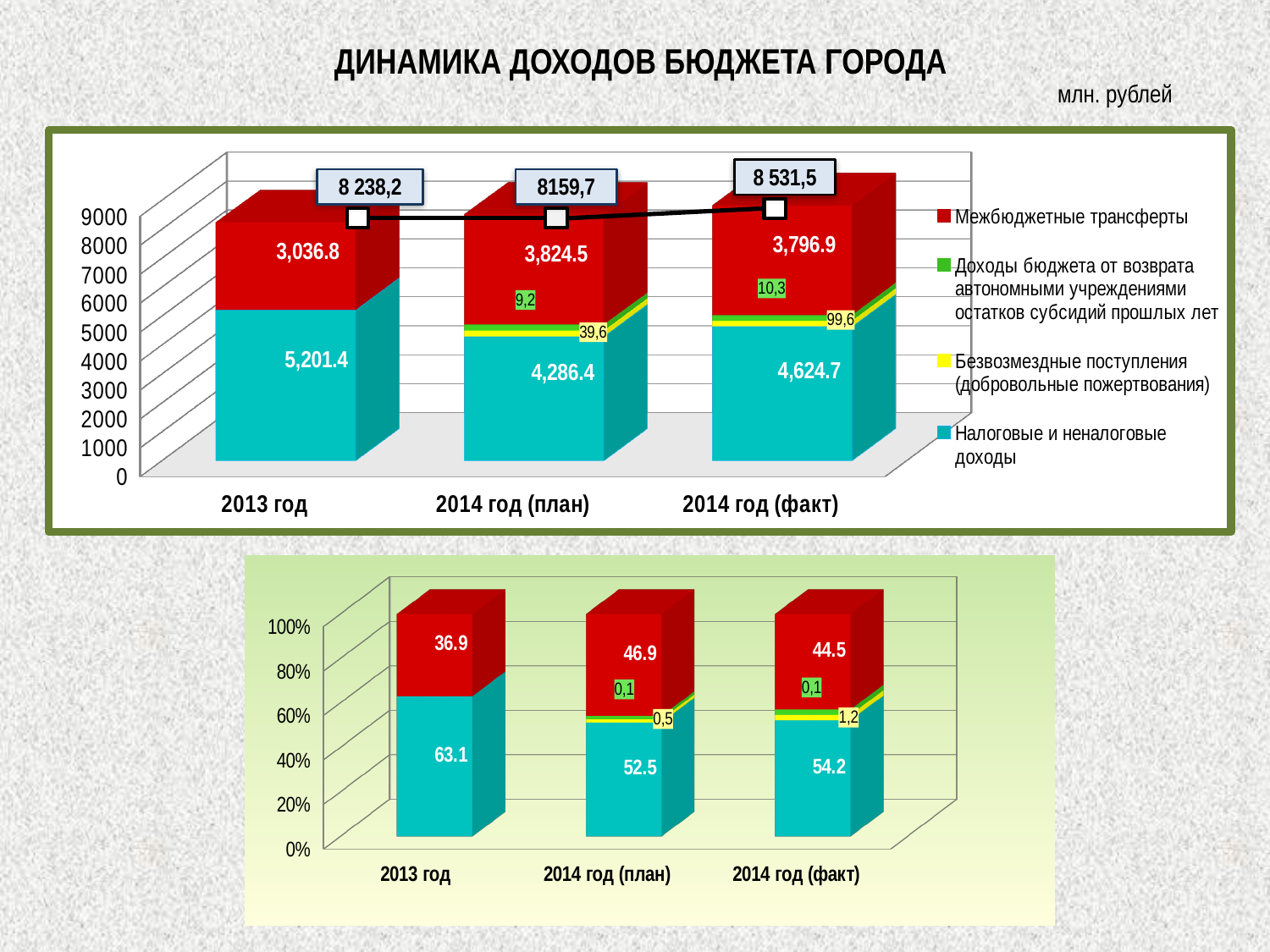
In the top chart, which category has the highest value for Налоговые и неналоговые доходы? 2013 год In the top chart, what is the value of Безвозмездные поступления (добровольные пожертвования) for 2014 год (факт)? 99,6 How many categories are shown on the x axis of the bottom chart? 3 In the top chart, what is the value of Межбюджетные трансферты for 2014 год (план)? 3,824.5 In the bottom chart, what is the share of Межбюджетные трансферты for 2013 год? 36.9 In the top chart, what is the difference between Межбюджетные трансферты for 2014 год (план) and 2014 год (факт)? 27.6 In the top chart, which is larger: Налоговые и неналоговые доходы for 2014 год (план) or for 2014 год (факт)? 2014 год (факт) In the bottom chart, what is the share of Налоговые и неналоговые доходы for 2014 год (факт)? 54.2 In the top chart, what total is shown above the bar for 2014 год (факт)? 8 531,5 What kind of chart is the bottom chart? Stacked bar chart In the top chart, what is the value of Налоговые и неналоговые доходы for 2013 год? 5,201.4 How many series does the legend of the top chart list? 4